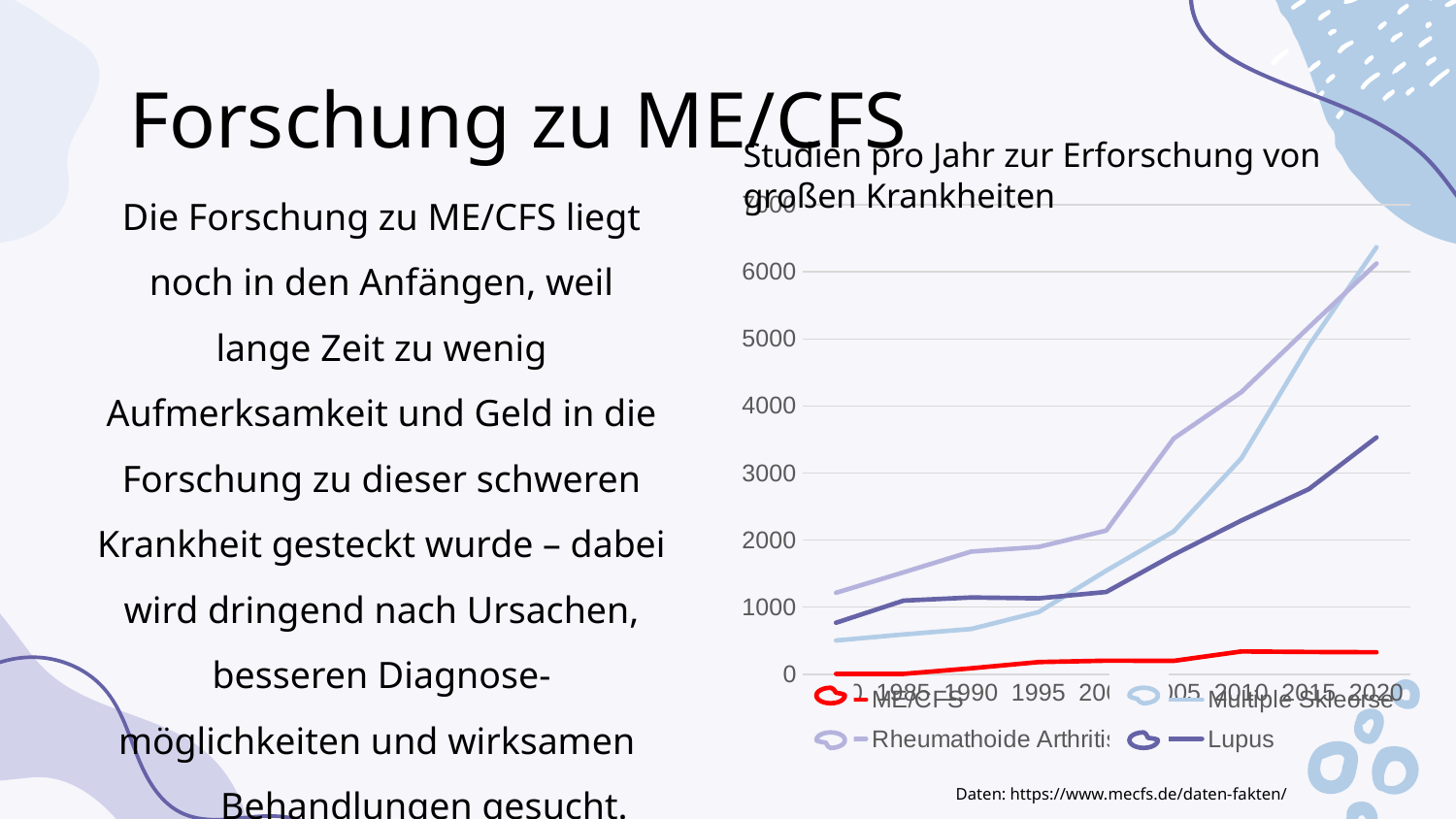
Which series has the highest value in 2010? Rheumathoide Arthritis Is the value for ME/CFS in 2020 greater or less than 1000? less Is the value for Lupus in 2020 greater or less than 3000? greater In 2020, which is larger: the value for Rheumathoide Arthritis or the value for Lupus? Rheumathoide Arthritis Which series has the lowest value in 2020? ME/CFS Does the Multiple Sklerose line rise or fall from 1980 to 2020? rise What kind of chart is shown on the slide? line chart Is the value for Rheumathoide Arthritis in 2020 greater or less than 5000? greater What colour is the ME/CFS line in the chart? red What is the title of the chart? Studien pro Jahr zur Erforschung von großen Krankheiten How many series does the chart legend list? 4